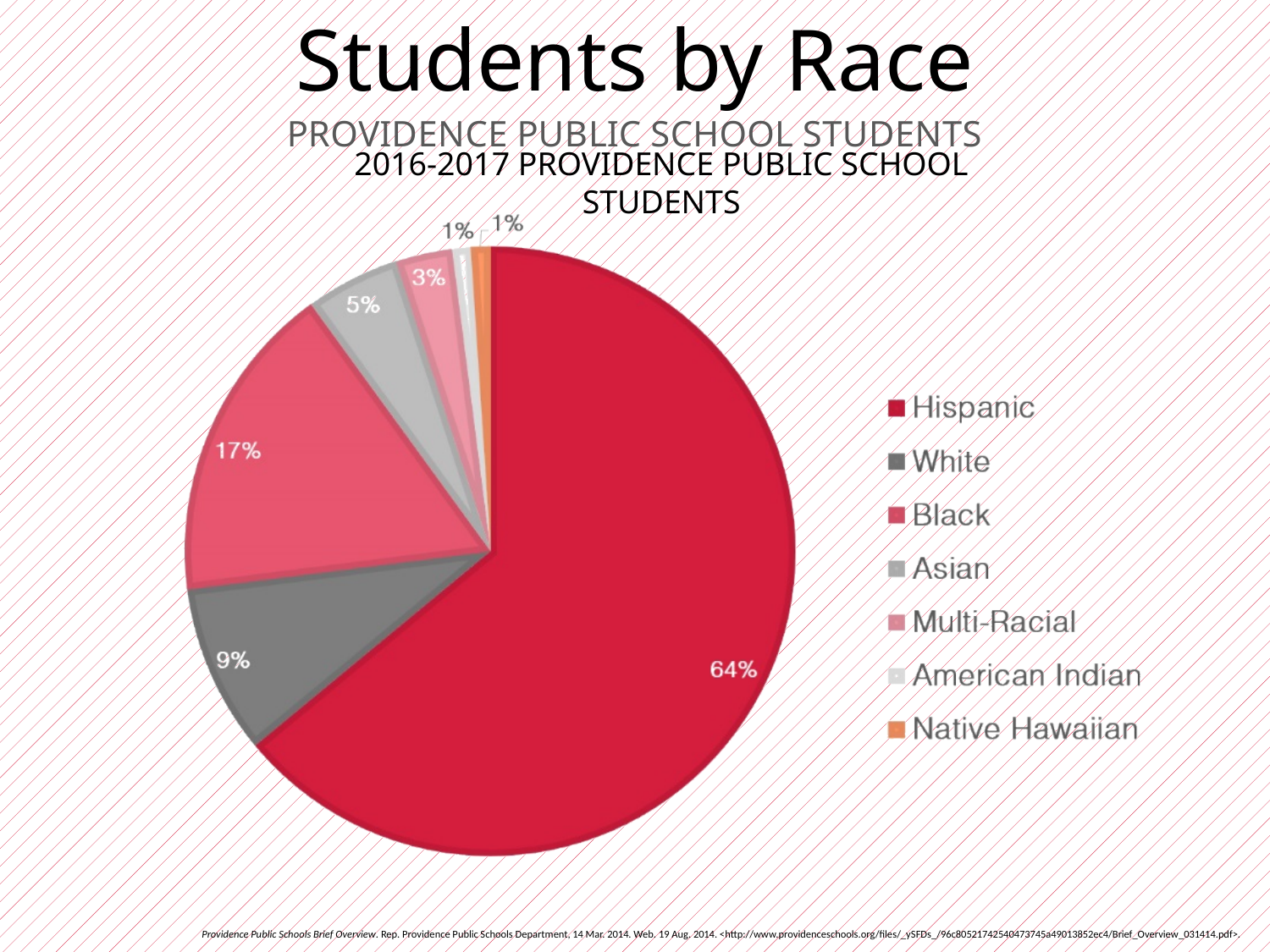
How many race categories does the legend list? 7 What share of students is Hispanic? 64% What share of students is Asian? 5% What is the difference in percentage points between the Black and White shares? 8 What is the title of the chart? 2016-2017 PROVIDENCE PUBLIC SCHOOL STUDENTS What share of students is Black? 17% What is the difference in percentage points between the Hispanic and Black shares? 47 Which race group has the largest share of students? Hispanic Which is larger, the share for White or the share for Asian? White What share of students is White? 9% What share of students is Multi-Racial? 3% What kind of chart is shown on the slide? Pie chart